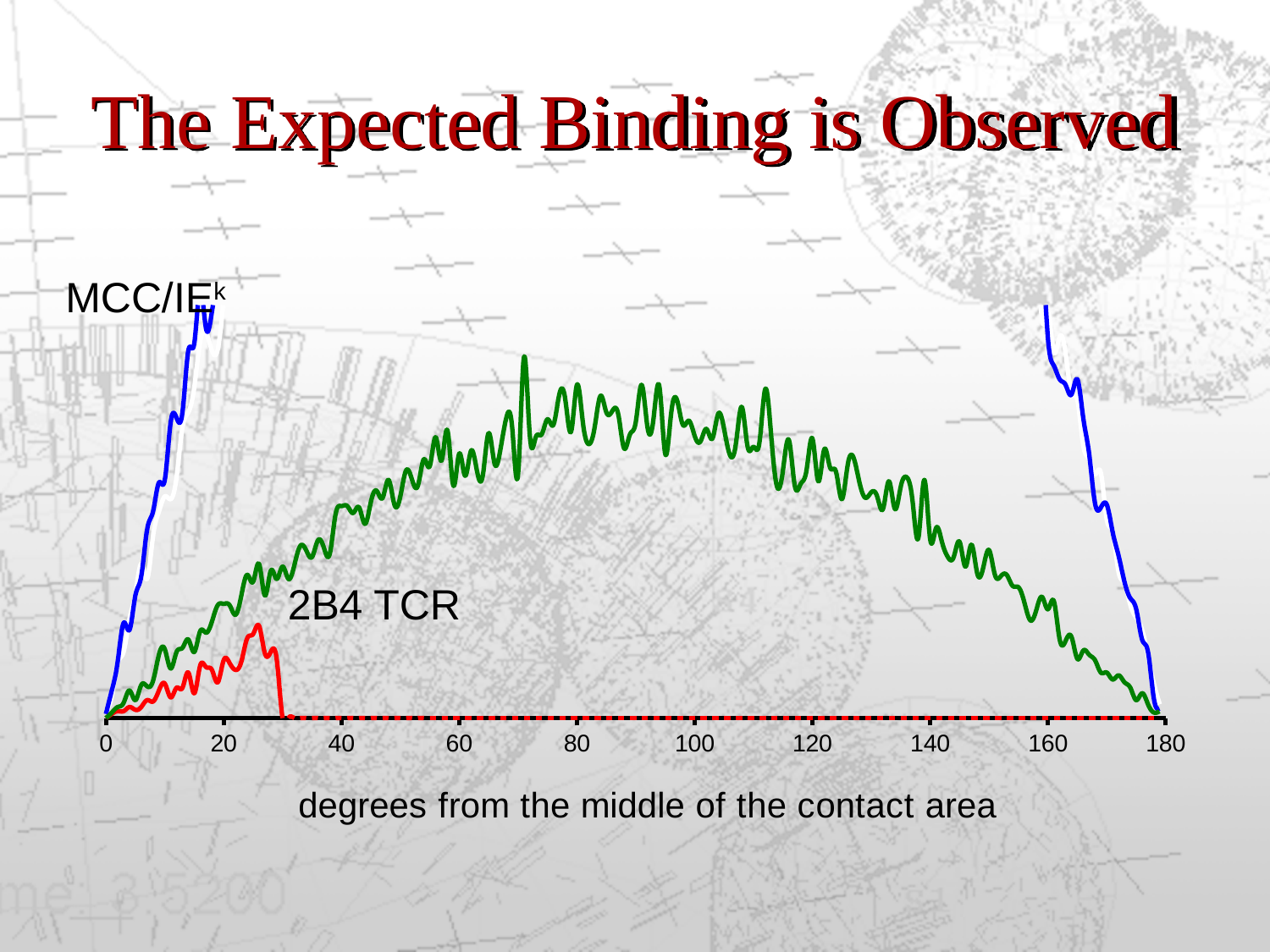
What colour is the line labelled 2B4 TCR? green Does the green 2B4 TCR line rise or fall between 0 and 60 degrees? rise At 20 degrees, which is higher: the blue MCC/IEk line or the green 2B4 TCR line? the blue MCC/IEk line Does the green 2B4 TCR line rise or fall between 100 and 180 degrees? fall At 20 degrees, which is higher: the green 2B4 TCR line or the red line? the green 2B4 TCR line What kind of chart is shown on the slide? line chart Does the red line drop to zero before or after 40 degrees? before What is the label of the x axis? degrees from the middle of the contact area Which line stays lowest across the chart? the red line What is the highest value shown on the x axis? 180 Which line reaches the highest point on the chart? the blue MCC/IEk line